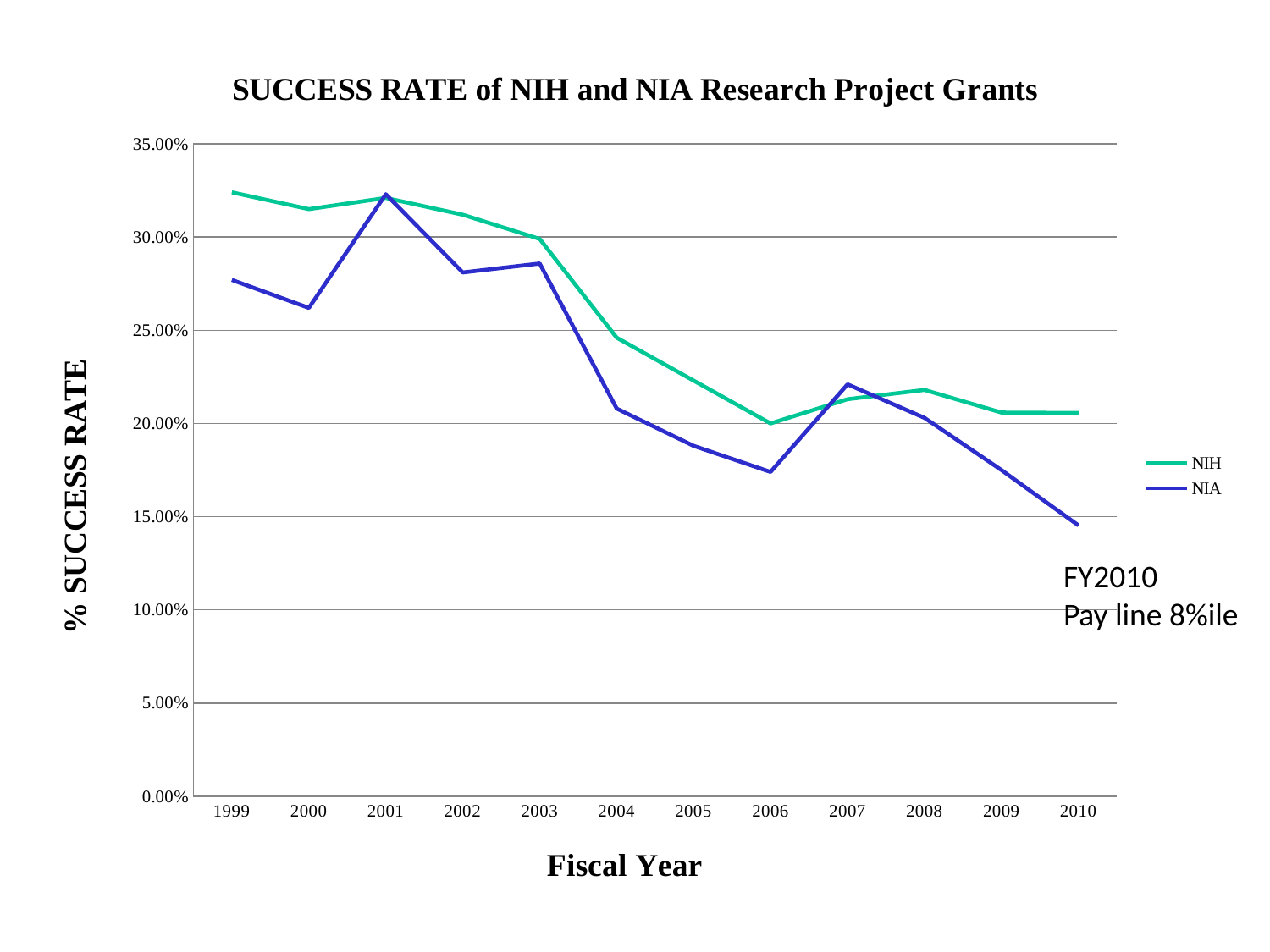
Is the NIA success rate for 2010 greater or less than 15.00%? less In which fiscal year does the NIA success rate reach its highest value? 2001 Is the NIH success rate for 2004 greater or less than 25.00%? less Is the NIH success rate for 1999 greater or less than 30.00%? greater In fiscal year 2005, which series has the higher success rate, NIH or NIA? NIH Does the NIA success rate overall rise or fall from 1999 to 2010? Fall What kind of chart is shown on the slide? Line chart How many series does the legend list? 2 In which fiscal year does the NIA success rate reach its lowest value? 2010 What is the title of the chart? SUCCESS RATE of NIH and NIA Research Project Grants How many fiscal years are plotted along the x axis? 12